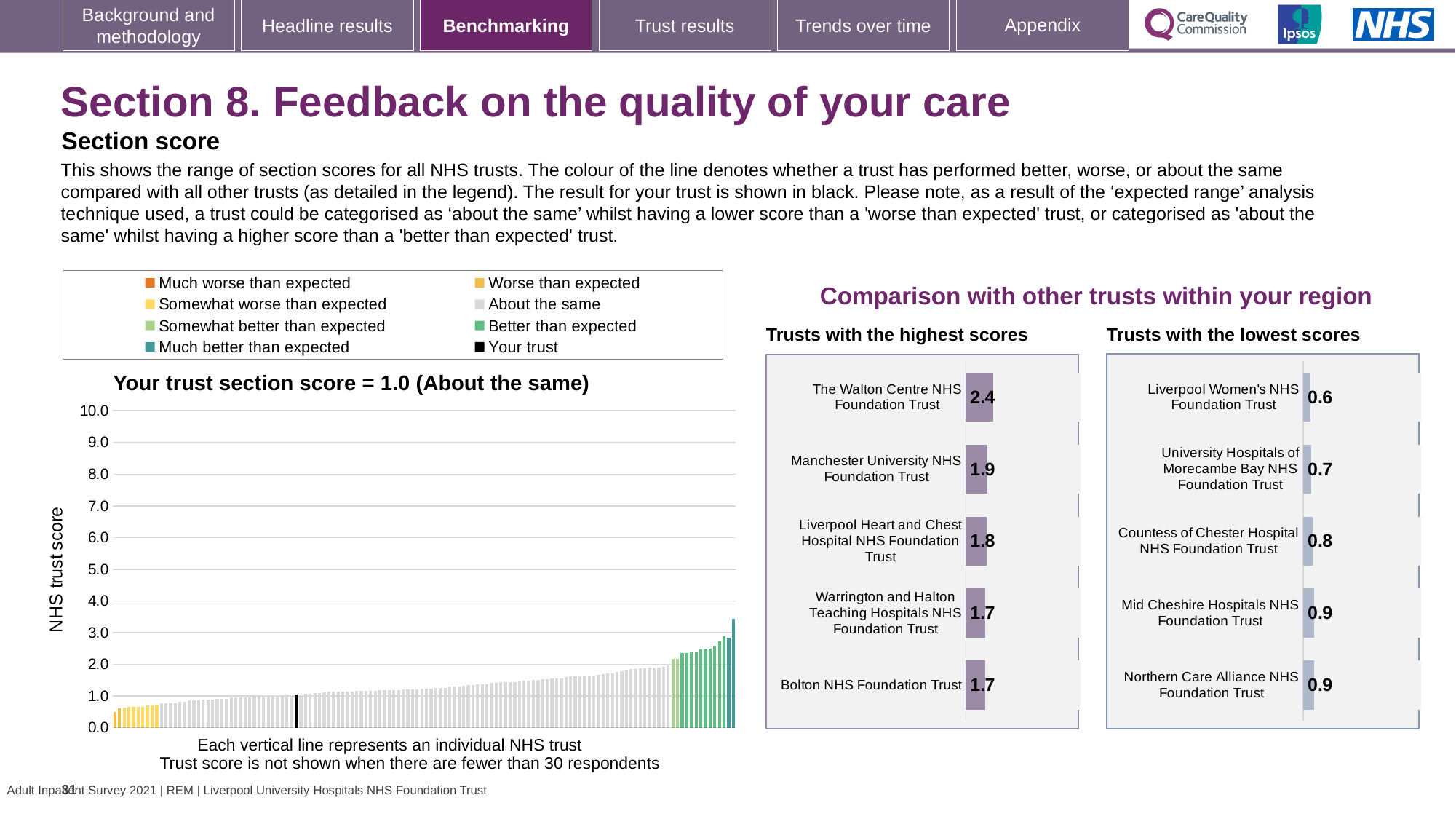
In the 'Trusts with the lowest scores' chart, what is the score for Liverpool Women's NHS Foundation Trust? 0.6 In the 'Trusts with the highest scores' chart, what is the difference between the scores of The Walton Centre NHS Foundation Trust and Manchester University NHS Foundation Trust? 0.5 What kind of chart is the main chart on the left showing NHS trust scores? Bar chart In the 'Trusts with the highest scores' chart, what is the score for The Walton Centre NHS Foundation Trust? 2.4 In the 'Trusts with the lowest scores' chart, which has the larger score: Countess of Chester Hospital NHS Foundation Trust or University Hospitals of Morecambe Bay NHS Foundation Trust? Countess of Chester Hospital NHS Foundation Trust In the 'Trusts with the lowest scores' chart, what is the score for Countess of Chester Hospital NHS Foundation Trust? 0.8 In the main chart on the left, is the value of the tallest bar greater or less than 3.0? greater According to the title of the main chart on the left, what is your trust's section score? 1.0 How many trusts are shown in the 'Trusts with the lowest scores' chart? 5 In the 'Trusts with the lowest scores' chart, which trust has the lowest score? Liverpool Women's NHS Foundation Trust In the 'Trusts with the highest scores' chart, what is the score for Manchester University NHS Foundation Trust? 1.9 In the 'Trusts with the highest scores' chart, which trust has the highest score? The Walton Centre NHS Foundation Trust